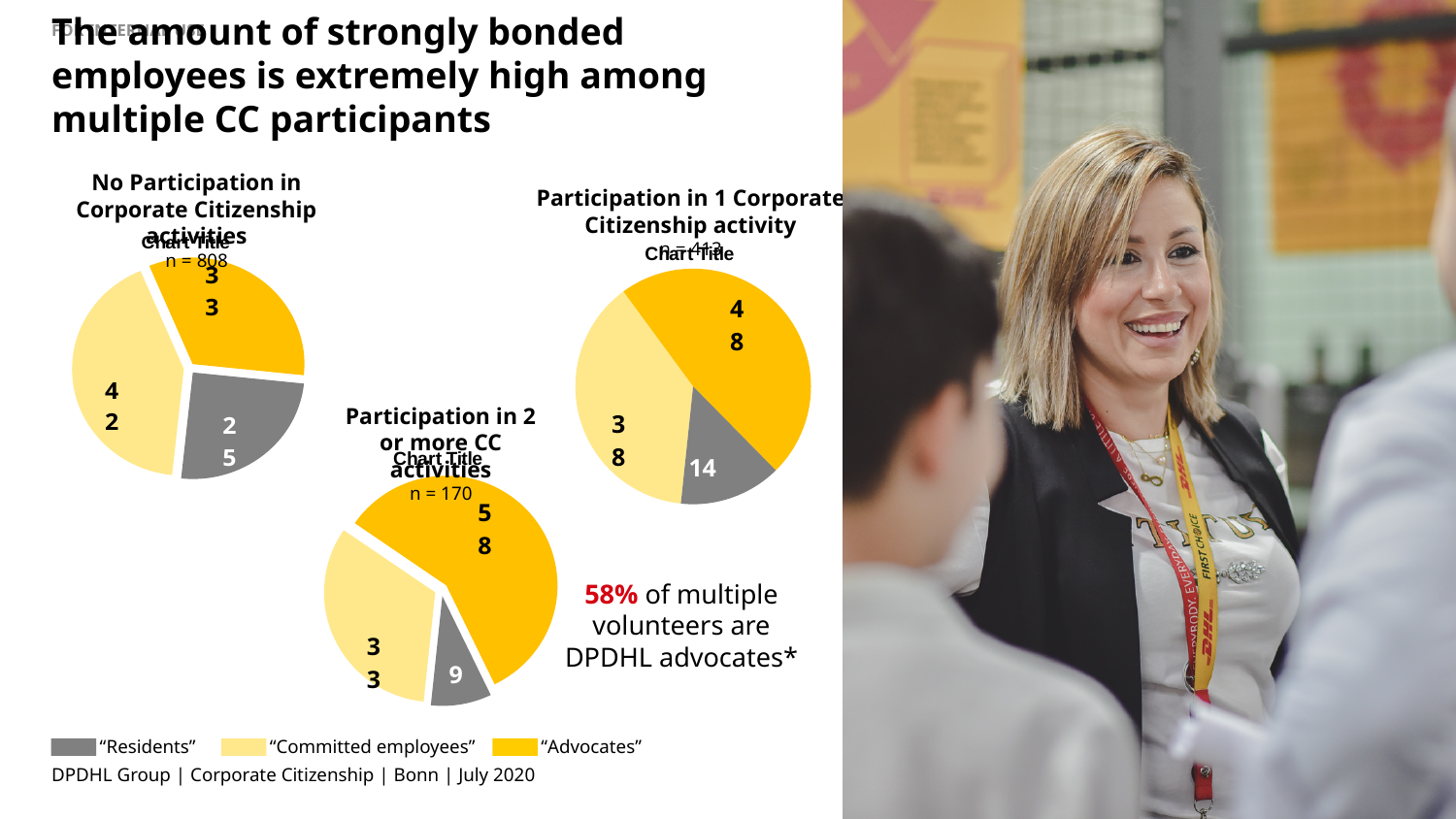
In the "No Participation in Corporate Citizenship activities" chart, which group has the largest slice? "Committed employees" In the "Participation in 2 or more CC activities" chart, what is the value for "Advocates"? 58 What is the sample size (n) shown for the "Participation in 2 or more CC activities" chart? n = 170 In the "Participation in 2 or more CC activities" chart, what is the value for "Residents"? 9 How many entries does the shared legend list? 3 What kind of chart is used for "Participation in 2 or more CC activities"? pie chart In the "Participation in 1 Corporate Citizenship activity" chart, what is the value for "Residents"? 14 In the "Participation in 2 or more CC activities" chart, which group has the largest slice? "Advocates" How many pie charts are shown on the slide? 3 In the "No Participation in Corporate Citizenship activities" chart, which slice is larger: "Residents" or "Advocates"? "Advocates" In the "Participation in 1 Corporate Citizenship activity" chart, which group has the smallest slice? "Residents" In the "Participation in 2 or more CC activities" chart, which group has the smallest slice? "Residents"